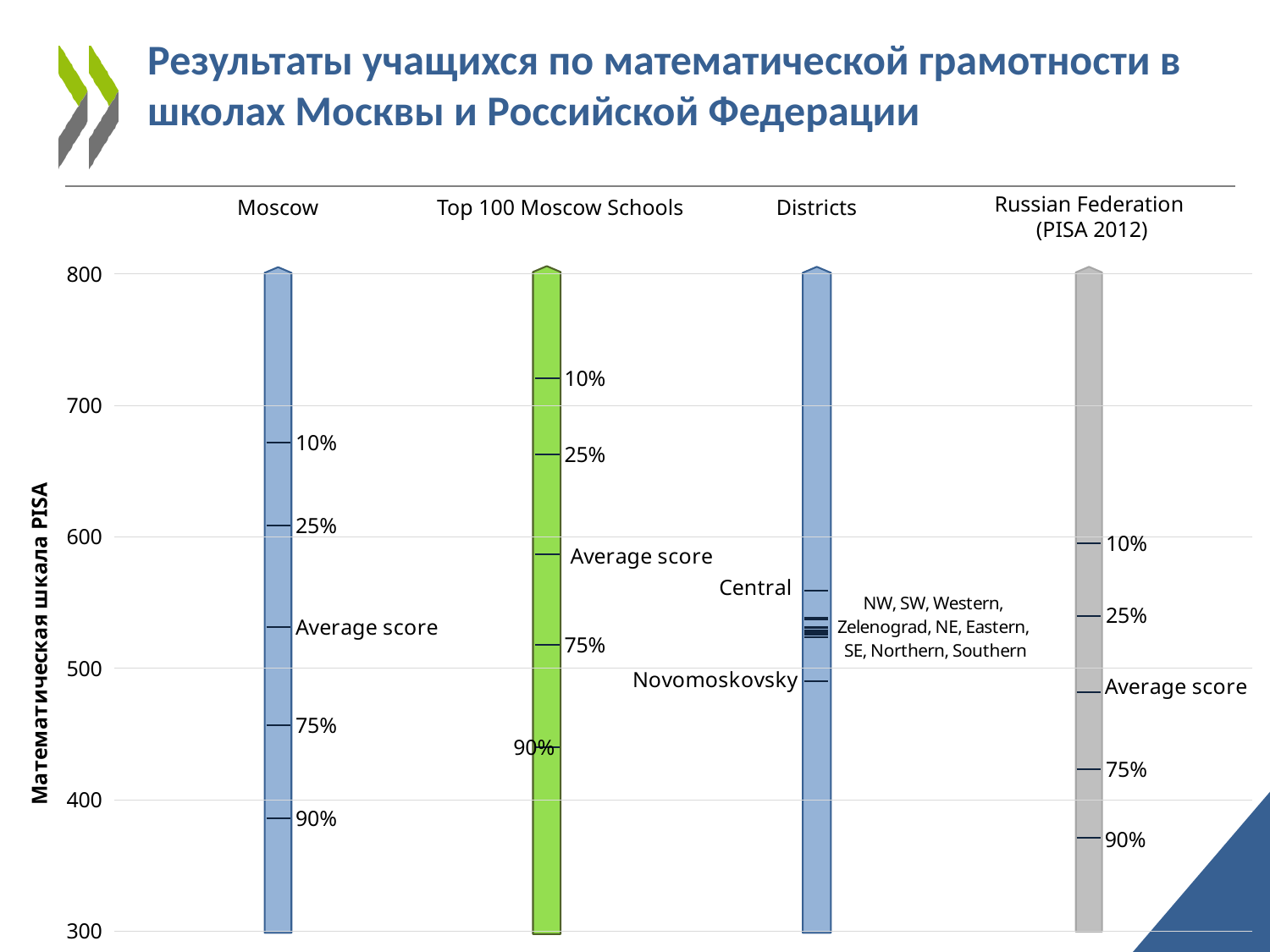
Is the Average score for the Russian Federation (PISA 2012) greater or less than 500? less Is the Central district value greater or less than 500? greater Is the Average score for Moscow greater or less than 500? greater Which has the higher Average score, Moscow or Top 100 Moscow Schools? Top 100 Moscow Schools How many groups (bars) are shown on the chart? 4 Which group's bar is coloured green? Top 100 Moscow Schools What is the label of the vertical axis? Математическая шкала PISA Among the Districts, which is higher, Central or Novomoskovsky? Central Which has the higher Average score, Moscow or the Russian Federation (PISA 2012)? Moscow